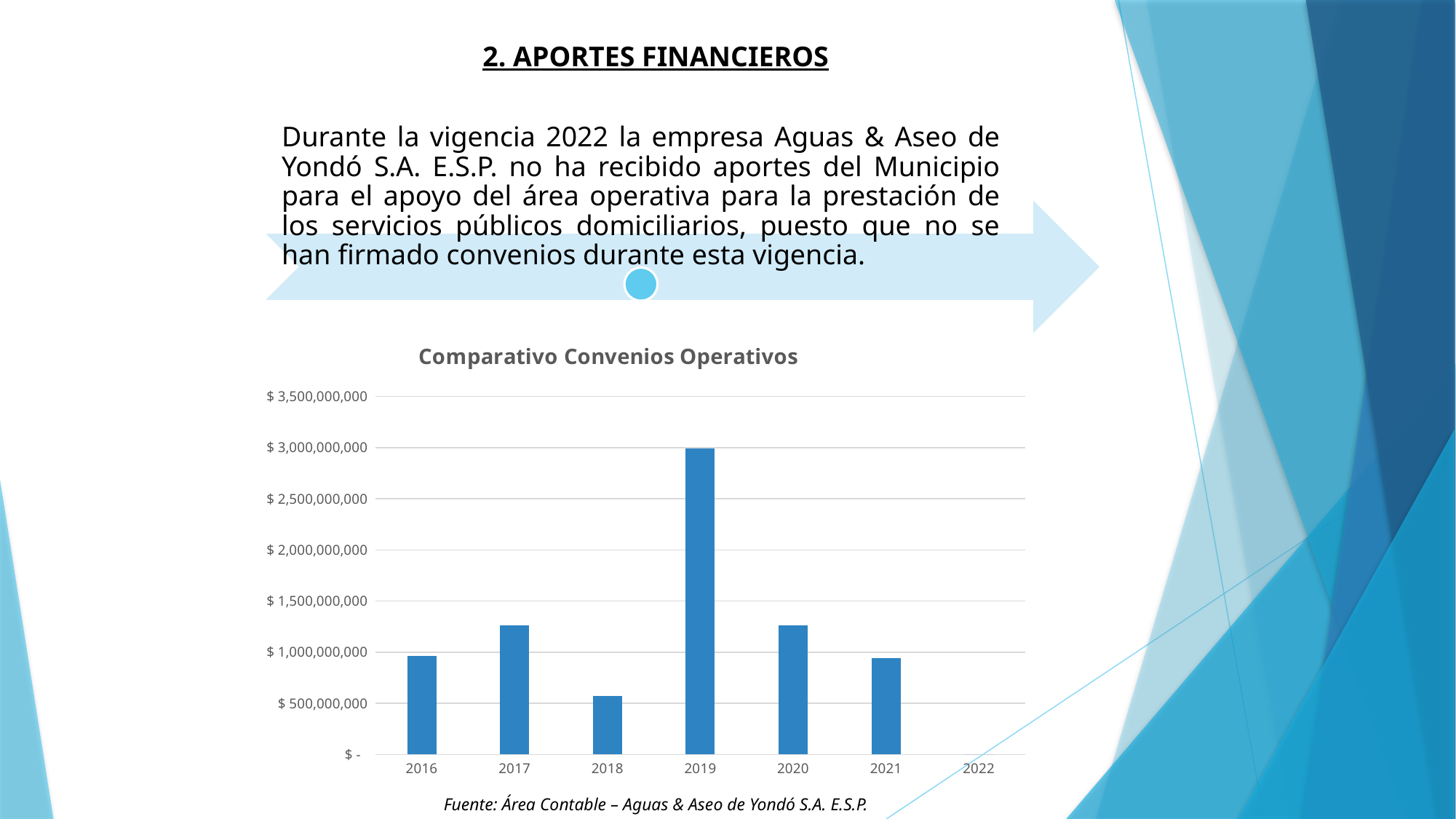
Is the value for 2017 greater or less than $ 1,000,000,000? greater What kind of chart is shown on the slide? Bar chart Which year shows no bar at all in the chart? 2022 Do the values rise or fall from 2019 to 2022? Fall How many years are shown on the x axis of the chart? 7 Among the years with a visible bar, which year has the lowest value? 2018 Is the value for 2018 greater or less than $ 1,000,000,000? less Which year has the larger value, 2018 or 2021? 2021 Which year has the larger value, 2019 or 2017? 2019 What is the title of the chart? Comparativo Convenios Operativos Is the value for 2019 greater or less than $ 2,500,000,000? greater Which year has the highest value in the chart? 2019